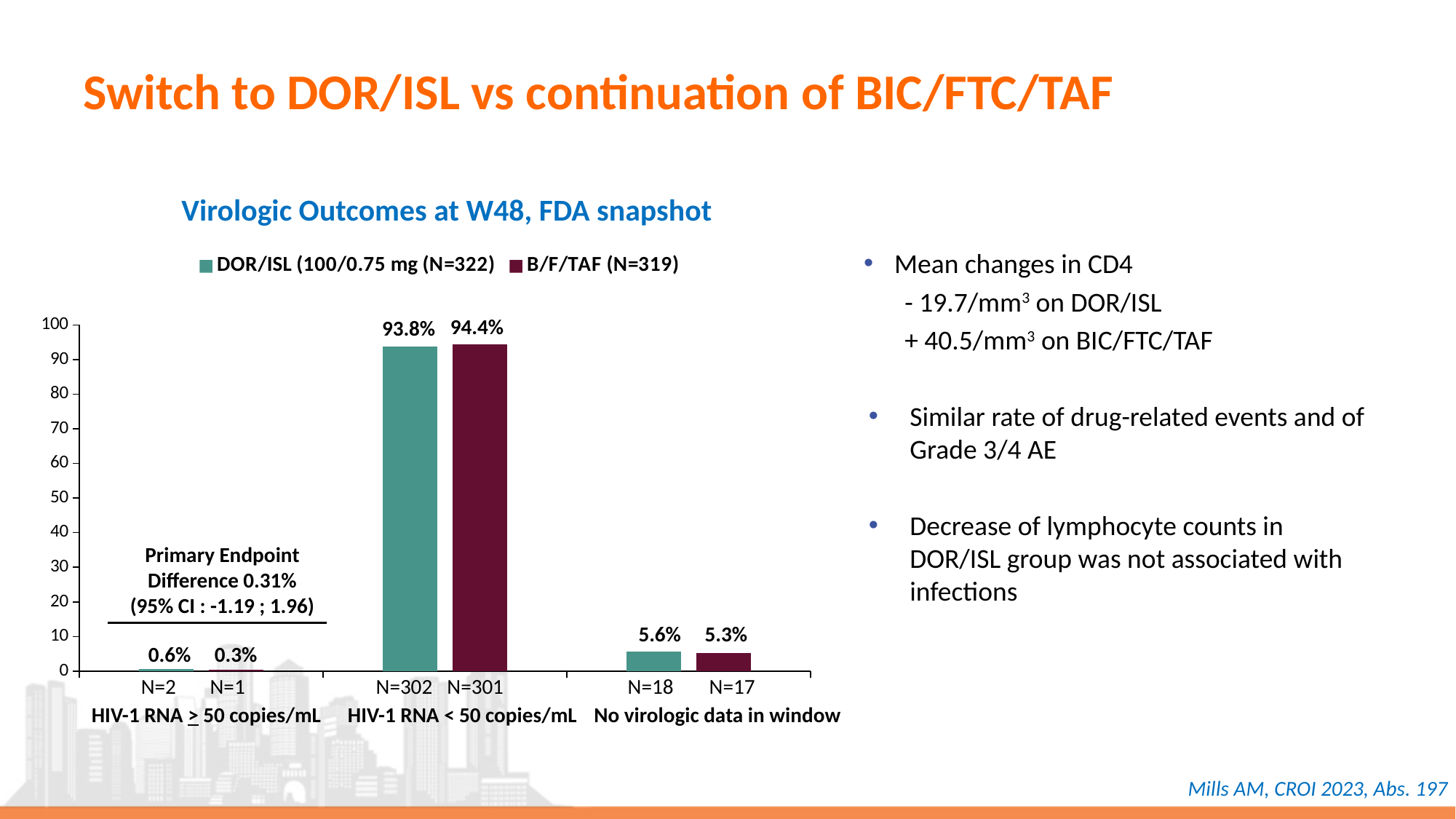
Which category has the lowest value for B/F/TAF? HIV-1 RNA > 50 copies/mL What kind of chart is shown on the slide? Bar chart What is the value for DOR/ISL in the HIV-1 RNA < 50 copies/mL category? 93.8% How many series does the legend list? 2 How many categories are shown on the x axis of the chart? 3 Is the value for B/F/TAF in the HIV-1 RNA < 50 copies/mL category greater or less than 90? greater What is the difference between the B/F/TAF and DOR/ISL values in the HIV-1 RNA < 50 copies/mL category? 0.6% In the No virologic data in window category, which series has the larger value, DOR/ISL or B/F/TAF? DOR/ISL Which category has the highest value for DOR/ISL? HIV-1 RNA < 50 copies/mL What is the value for B/F/TAF in the HIV-1 RNA > 50 copies/mL category? 0.3% What is the value for B/F/TAF in the HIV-1 RNA < 50 copies/mL category? 94.4% What is the value for DOR/ISL in the No virologic data in window category? 5.6%